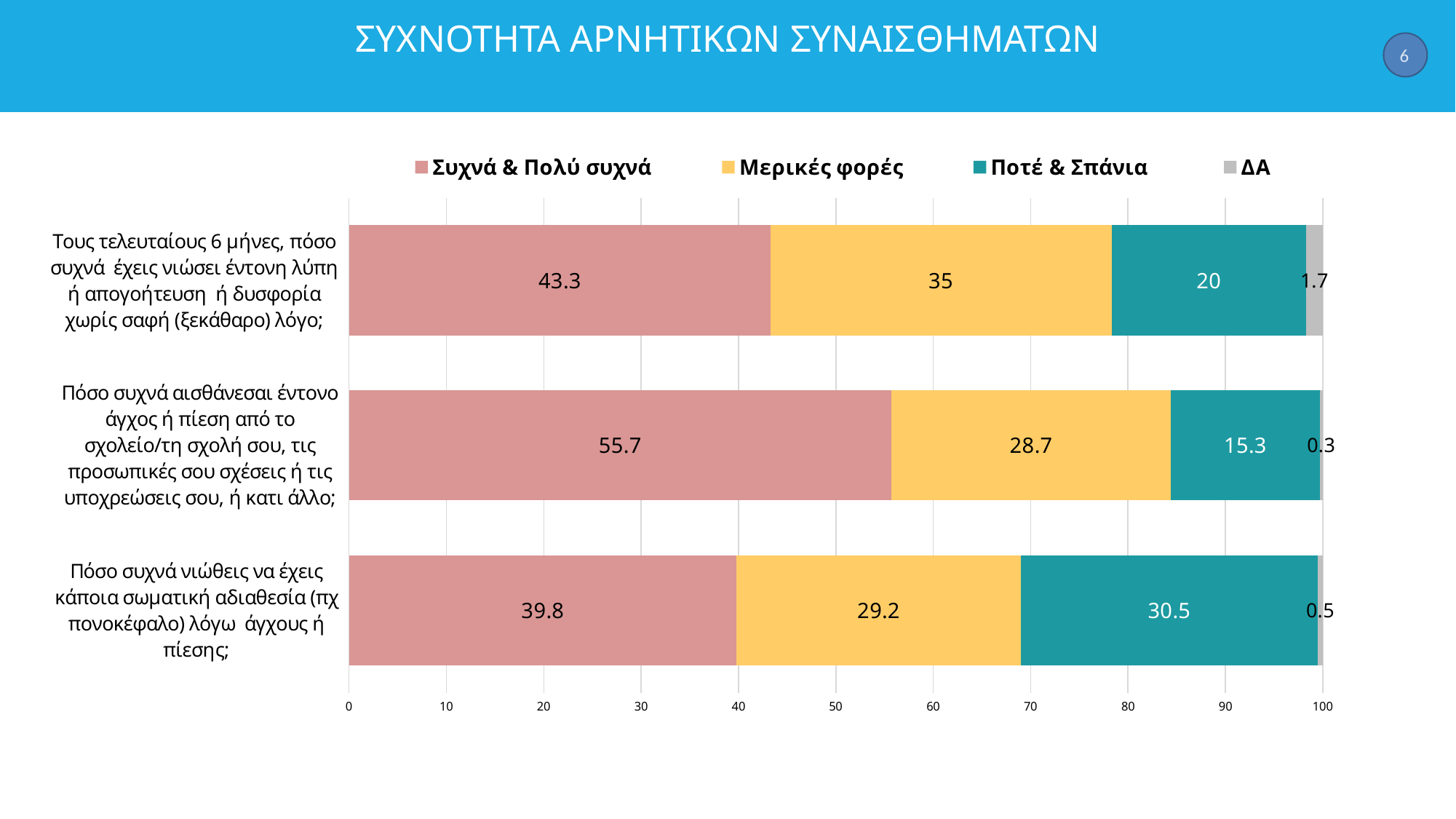
What is the difference between the 'Συχνά & Πολύ συχνά' values for the question about έντονο άγχος ή πίεση (55.7) and the question about έντονη λύπη ή απογοήτευση (43.3)? 12.4 What is the value of 'Μερικές φορές' for the question 'Τους τελευταίους 6 μήνες, πόσο συχνά έχεις νιώσει έντονη λύπη ή απογοήτευση...'? 35 What type of chart is shown on the slide? Stacked bar chart What is the value of 'Ποτέ & Σπάνια' for the question 'Πόσο συχνά νιώθεις να έχεις κάποια σωματική αδιαθεσία (πχ πονοκέφαλο)...'? 30.5 Which question has the highest 'Συχνά & Πολύ συχνά' value? Πόσο συχνά αισθάνεσαι έντονο άγχος ή πίεση από το σχολείο/τη σχολή σου, τις προσωπικές σου σχέσεις ή τις υποχρεώσεις σου, ή κατι άλλο; What is the value of 'Συχνά & Πολύ συχνά' for the question 'Πόσο συχνά αισθάνεσαι έντονο άγχος ή πίεση από το σχολείο/τη σχολή σου...'? 55.7 What is the 'ΔΑ' value for the question 'Τους τελευταίους 6 μήνες, πόσο συχνά έχεις νιώσει έντονη λύπη ή απογοήτευση...'? 1.7 What is the total of the stacked bar for the question 'Πόσο συχνά νιώθεις να έχεις κάποια σωματική αδιαθεσία (πχ πονοκέφαλο)...'? 100 Which question has the lowest 'Ποτέ & Σπάνια' value? Πόσο συχνά αισθάνεσαι έντονο άγχος ή πίεση από το σχολείο/τη σχολή σου, τις προσωπικές σου σχέσεις ή τις υποχρεώσεις σου, ή κατι άλλο; Which is larger: the 'Μερικές φορές' value for the question about σωματική αδιαθεσία or the 'Ποτέ & Σπάνια' value for the same question? Ποτέ & Σπάνια (30.5) How many series does the legend list? 4 How many categories (questions) are plotted on the chart? 3